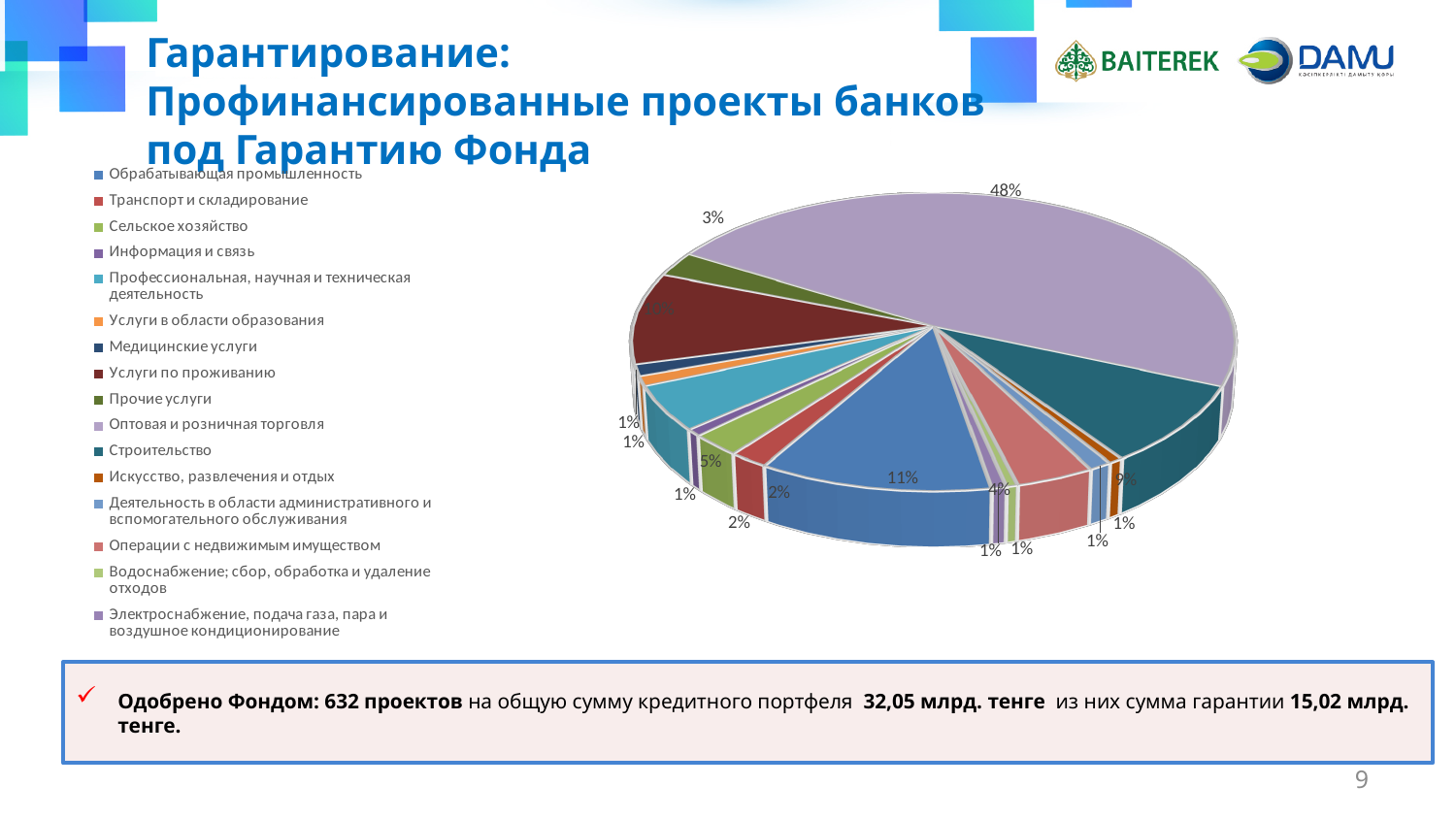
What colour is the largest slice of the pie chart? light purple What is the smallest percentage value labelled on the pie chart? 1% What is the title of the slide containing the pie chart? Гарантирование: Профинансированные проекты банков под Гарантию Фонда What share of the pie does the largest slice (Оптовая и розничная торговля) represent? 48% How many categories does the legend of the pie chart list? 16 By how many percentage points does the share for Оптовая и розничная торговля (48%) exceed the share for Обрабатывающая промышленность (11%)? 37 percentage points Which category has the largest slice of the pie chart? Оптовая и розничная торговля What kind of chart is shown on the slide? pie chart What percentage is shown for Профессиональная, научная и техническая деятельность? 5% What percentage is shown for Прочие услуги? 3% Which is larger: the share for Оптовая и розничная торговля or the share for Обрабатывающая промышленность? Оптовая и розничная торговля What percentage is shown for Обрабатывающая промышленность? 11%